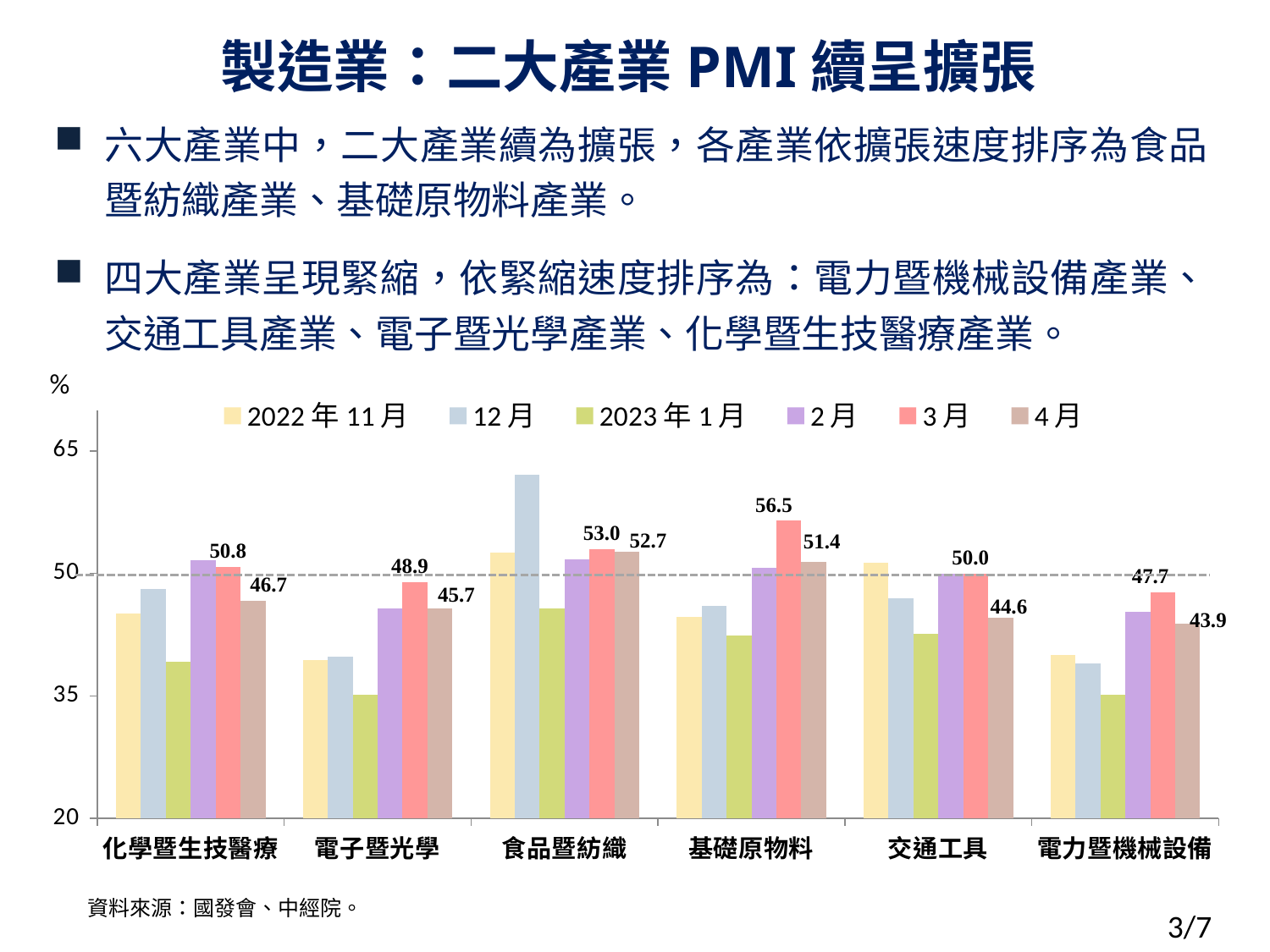
Is the 12月 value for 食品暨紡織 greater or less than 50? greater What is the 4月 value for 交通工具? 44.6 What kind of chart is shown on the slide? bar chart Which is larger, the 4月 value for 化學暨生技醫療 or the 4月 value for 電子暨光學? 化學暨生技醫療 Is the 2023 年 1 月 value for 電力暨機械設備 greater or less than 50? less What is the 4月 value for 食品暨紡織? 52.7 How many series does the legend list? 6 What is the 3月 value for 基礎原物料? 56.5 Which industry has the lowest 4月 value? 電力暨機械設備 How many industries are shown on the x axis? 6 Which industry has the highest 3月 value? 基礎原物料 What is the difference between the 3月 and 4月 values for 交通工具? 5.4